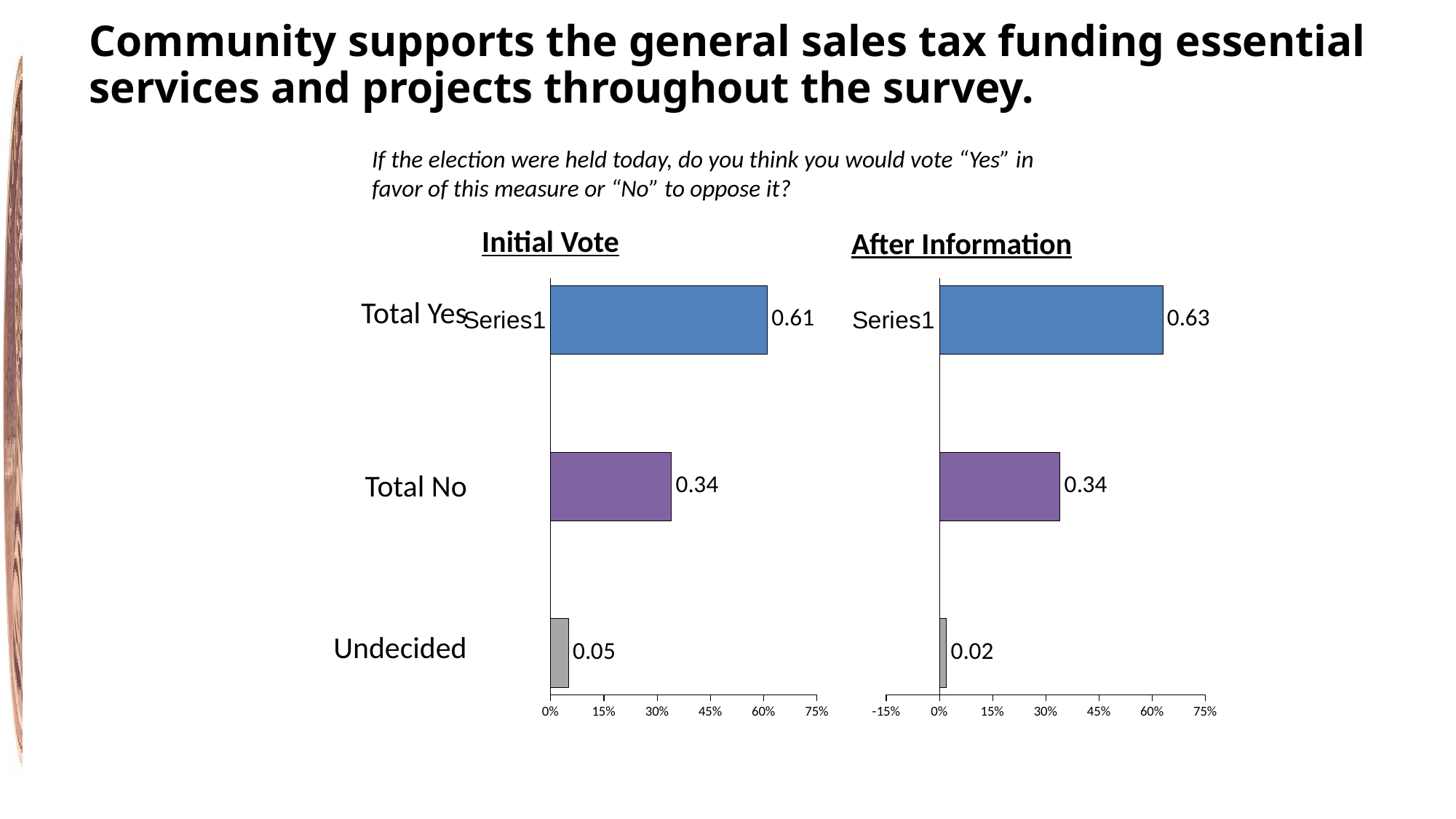
What is the difference between the Undecided value in the Initial Vote chart and the Undecided value in the After Information chart? 0.03 In the Initial Vote chart, which category has the highest value? Total Yes Which is larger: Total Yes in the Initial Vote chart or Total Yes in the After Information chart? After Information In the Initial Vote chart, what is the value for Undecided? 0.05 In the After Information chart, what is the value for Undecided? 0.02 In the Initial Vote chart, what is the value for Total Yes? 0.61 In the After Information chart, what is the value for Total No? 0.34 What type of chart is the After Information chart? Bar chart In the After Information chart, which category has the lowest value? Undecided How many categories are shown in the Initial Vote chart? 3 In the Initial Vote chart, what is the difference between the Total Yes and Total No values? 0.27 In the After Information chart, what is the value for Total Yes? 0.63